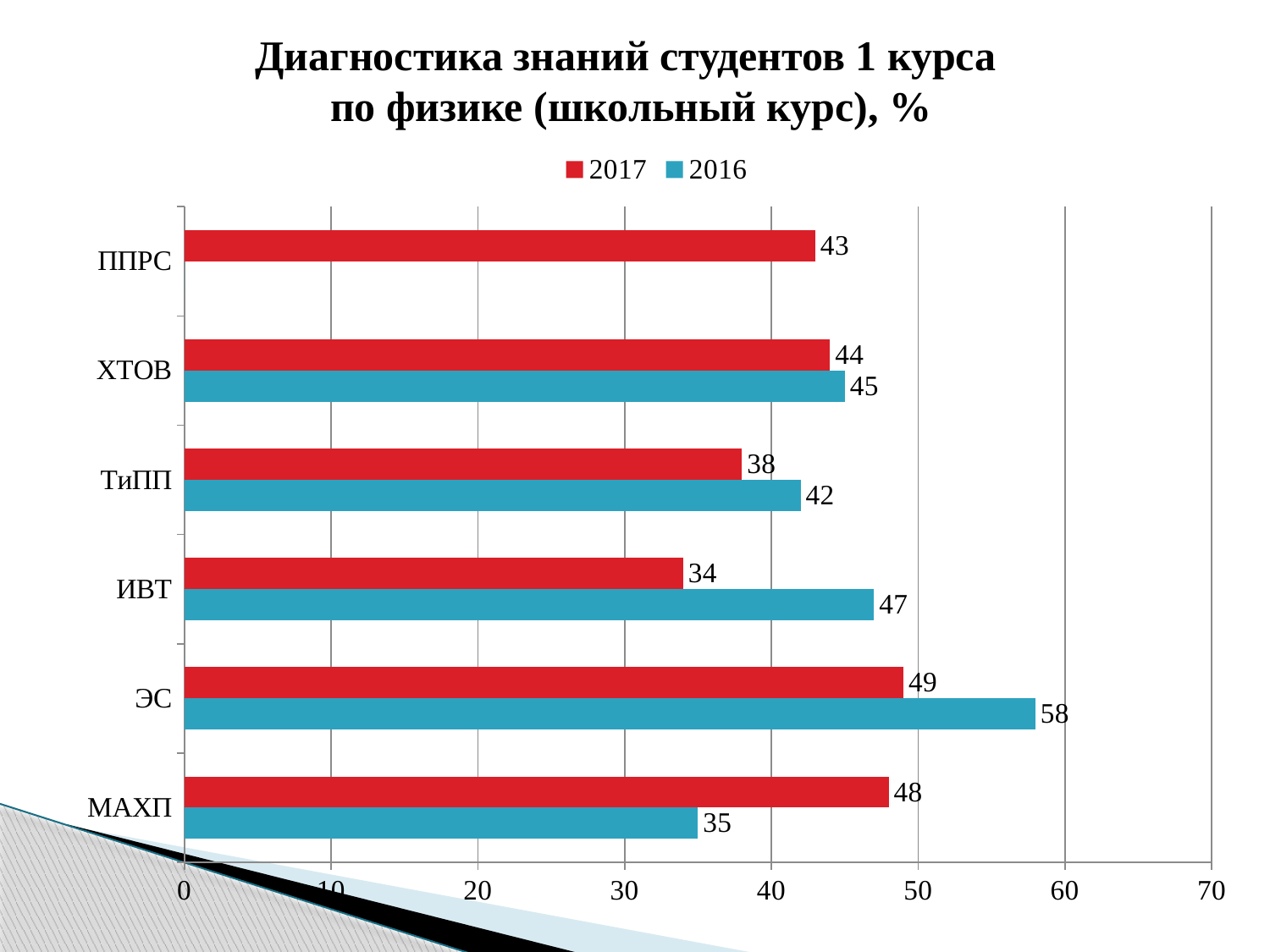
What is the difference between the 2017 and 2016 values for МАХП? 13 What is the 2016 value for ИВТ? 47 What is the 2017 value for ППРС? 43 How many categories are shown on the chart? 6 What is the 2017 value for ЭС? 49 Which category has the lowest 2017 value? ИВТ Which colour represents the 2016 series? blue What is the difference between the 2016 and 2017 values for ИВТ? 13 Which is larger for ТиПП, the 2017 value or the 2016 value? 2016 How many series does the legend list? 2 What kind of chart is shown on the slide? bar chart Which category has the highest 2016 value? ЭС